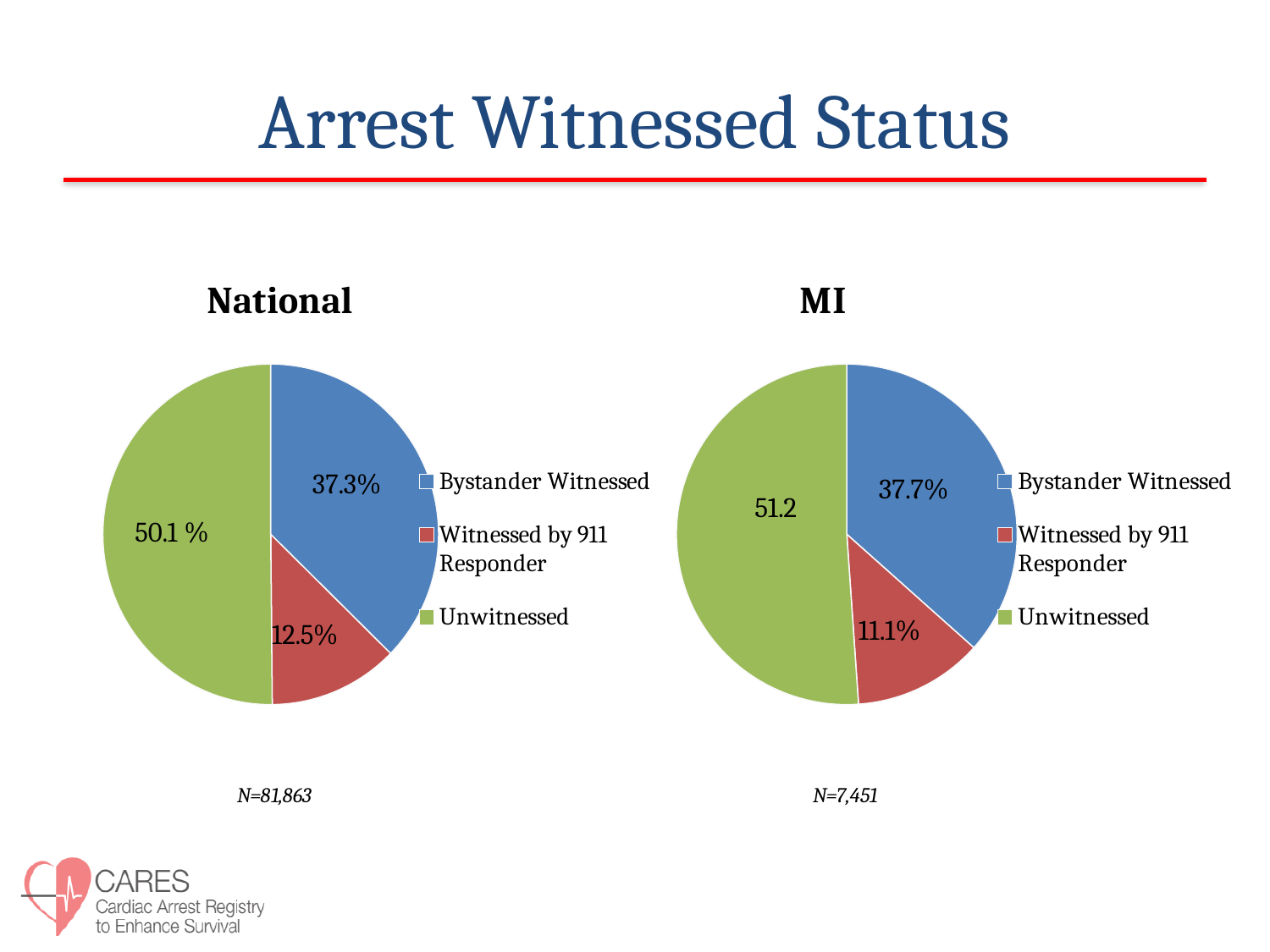
What kind of chart is the MI chart? Pie chart Which is larger: Bystander Witnessed in the National chart or Bystander Witnessed in the MI chart? MI In the National chart, what is the value for Witnessed by 911 Responder? 12.5% In the MI chart, what is the value labelled on the Unwitnessed slice? 51.2 In the National chart, what is the value for Unwitnessed? 50.1 % In the National chart, what is the value for Bystander Witnessed? 37.3% In the National chart, what is the difference between the Bystander Witnessed and Witnessed by 911 Responder values? 24.8% In the MI chart, what is the value for Bystander Witnessed? 37.7% How many categories does the legend of the National chart list? 3 In the MI chart, what is the value for Witnessed by 911 Responder? 11.1% In the MI chart, which category has the smallest slice? Witnessed by 911 Responder In the National chart, which category has the largest slice? Unwitnessed